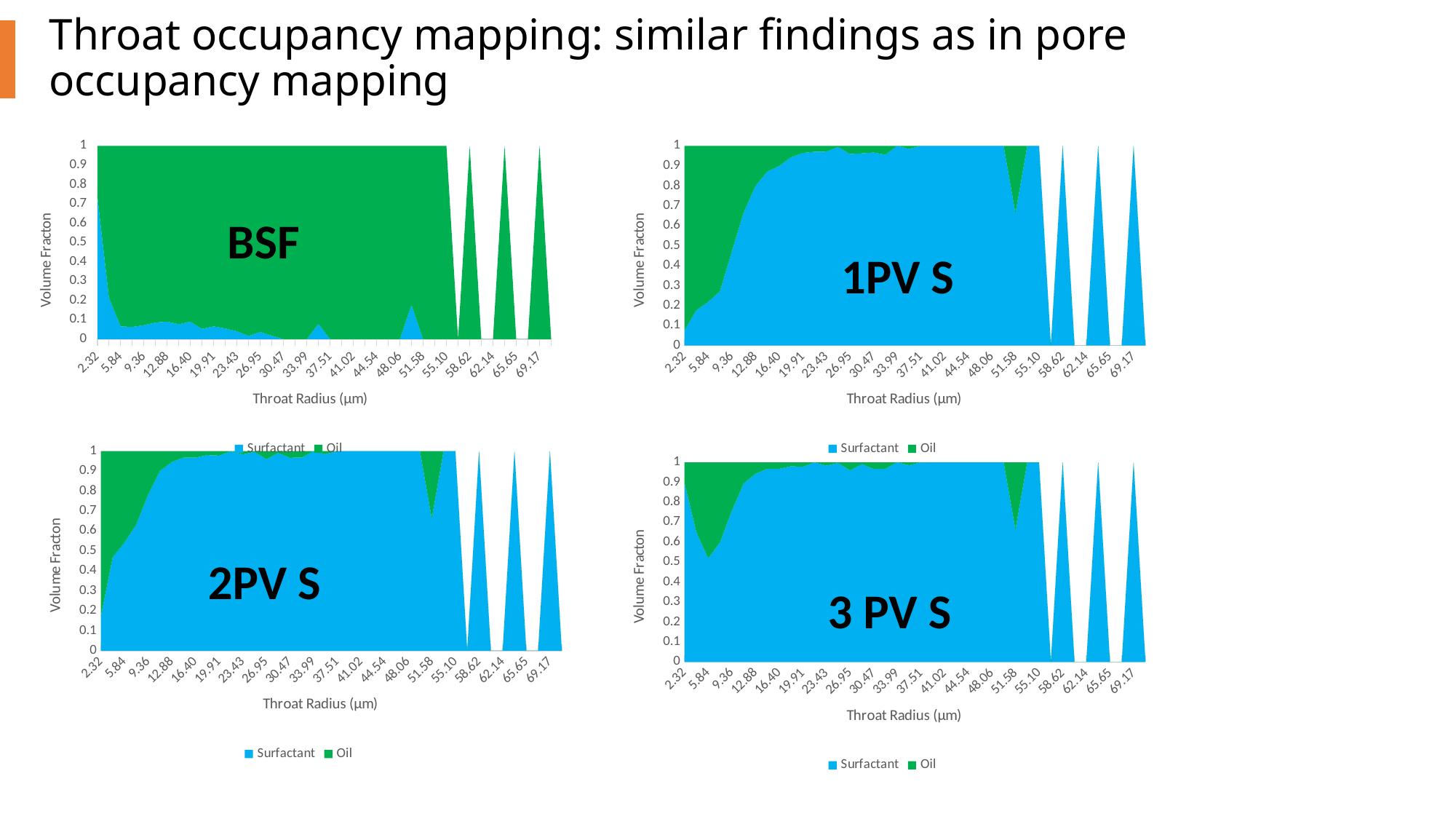
In the BSF chart, is the Surfactant volume fraction at a throat radius of 30.47 greater or less than 0.1? less How many series does the legend of the 1PV S chart list? 2 How many charts are shown on the slide? 4 What are the two series named in the legend of the 2PV S chart? Surfactant and Oil In the 2PV S chart, is the Surfactant volume fraction at a throat radius of 51.58 greater or less than 0.9? less In the 1PV S chart, does the Surfactant volume fraction rise or fall as the throat radius increases from 2.32 to 19.91? rise In the 1PV S chart, is the Surfactant volume fraction at a throat radius of 30.47 greater or less than 0.9? greater What kind of chart is the BSF chart? Stacked area chart What is the x-axis title of the 3 PV S chart? Throat Radius (µm) In the 3 PV S chart, which series has the larger volume fraction at a throat radius of 30.47, Surfactant or Oil? Surfactant In the BSF chart, which series has the larger volume fraction at a throat radius of 30.47, Surfactant or Oil? Oil